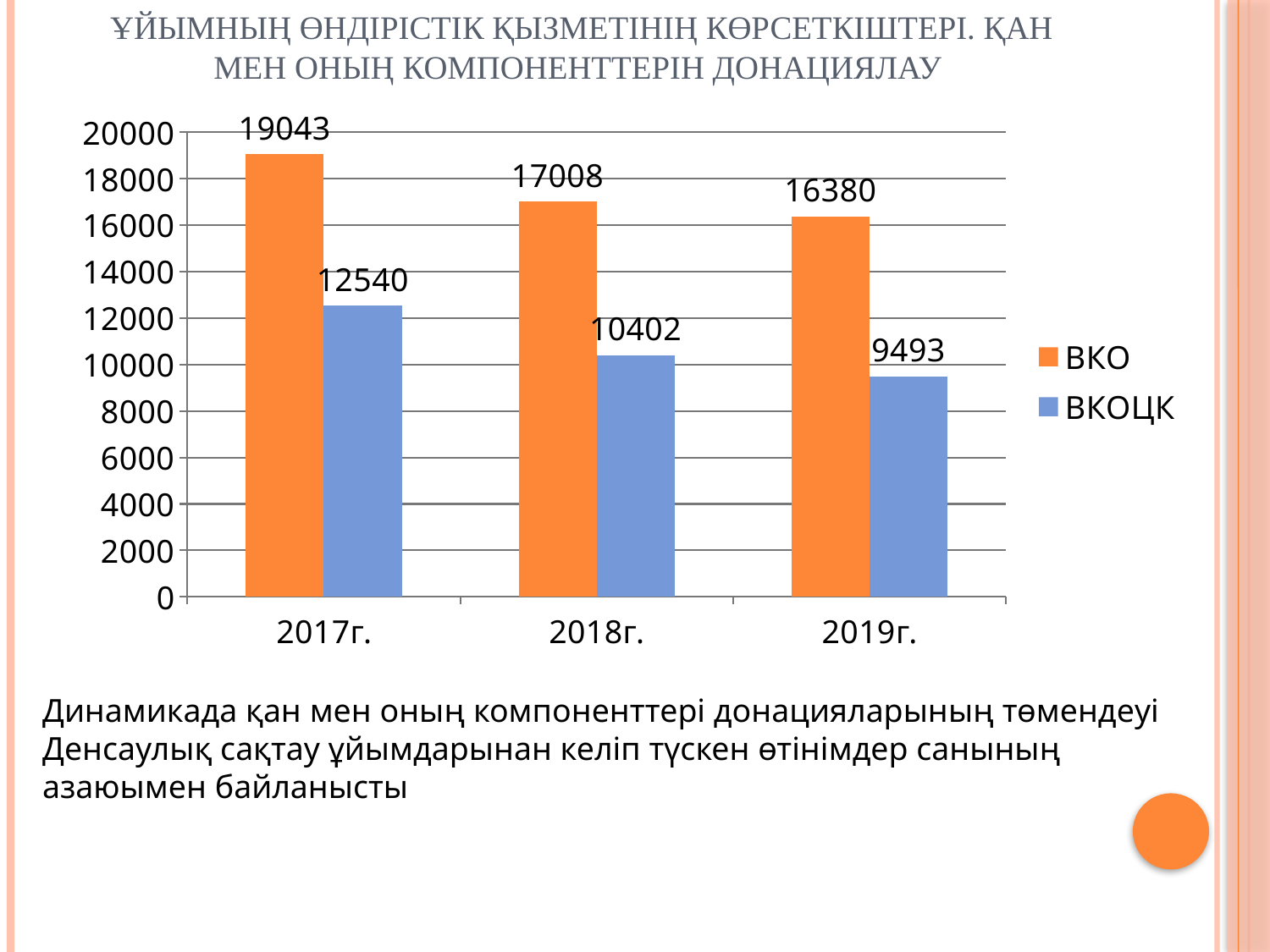
Is the value for ВКОЦК in 2017г. greater or less than 12000? greater How many series does the legend list? 2 What is the difference between the ВКО and ВКОЦК values in 2017г.? 6503 What kind of chart is shown on the slide? bar chart What is the value for ВКОЦК in 2019г.? 9493 What is the difference between the ВКО values for 2018г. and 2019г.? 628 How many years are shown on the x axis? 3 In which year is the ВКОЦК value lowest? 2019г. Which is larger in 2019г., ВКО or ВКОЦК? ВКО What is the value for ВКО in 2017г.? 19043 In which year is the ВКО value highest? 2017г. What is the value for ВКОЦК in 2018г.? 10402